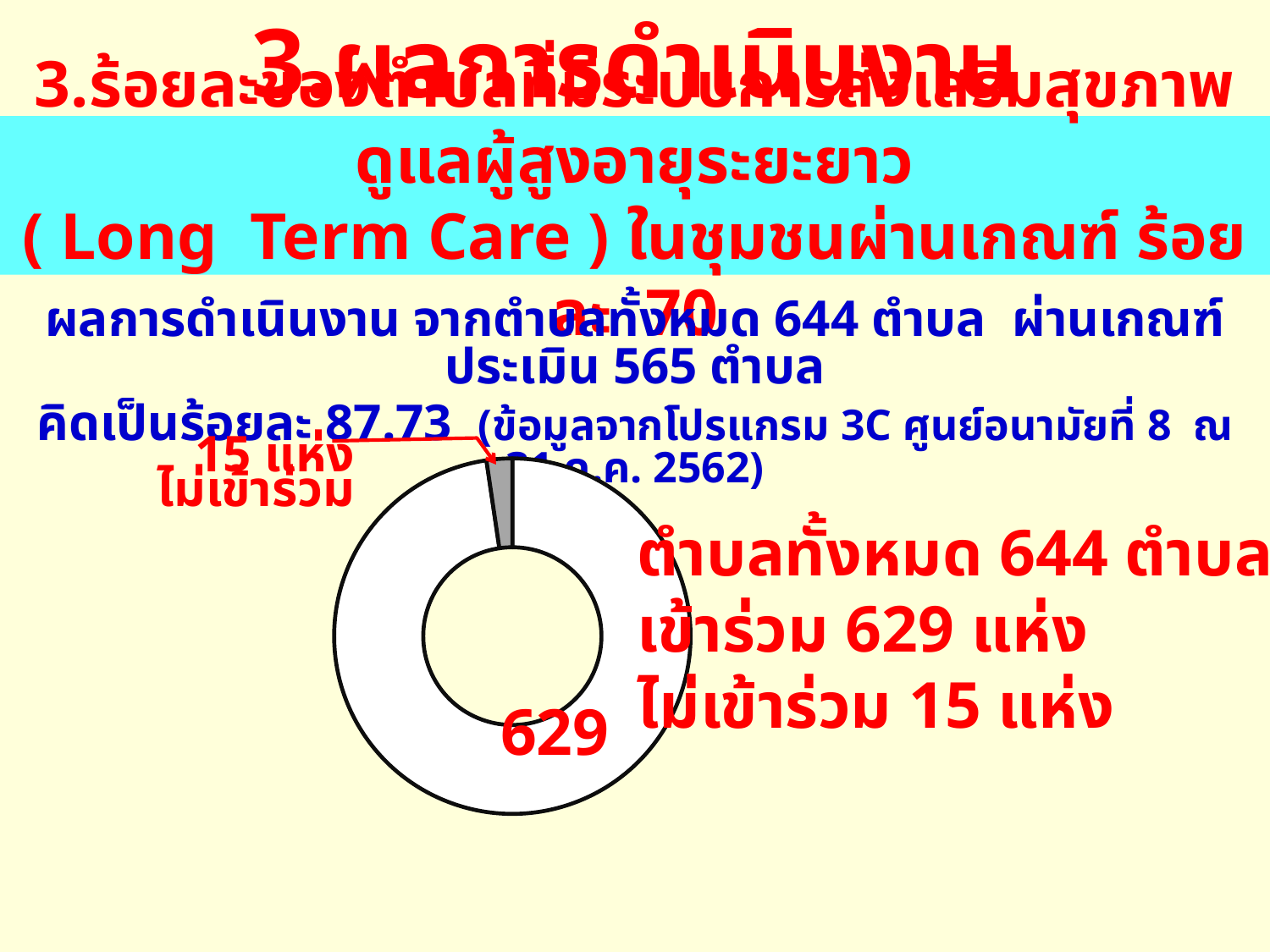
How many slices does the doughnut chart have? 2 What share of the total 644 sub-districts does the 15 ไม่เข้าร่วม slice represent, to one decimal place? 2.3% What is the difference between the number of participating (629) and non-participating (15) sub-districts? 614 What colour is the slice representing the 15 non-participating sub-districts? Grey Which slice of the doughnut chart is the largest? 629 (เข้าร่วม) What is the total of the two slices in the doughnut chart? 644 What value is given for the small grey slice labelled ไม่เข้าร่วม? 15 แห่ง What kind of chart is shown on the slide? Doughnut (pie) chart Which is larger: the slice for เข้าร่วม or the slice for ไม่เข้าร่วม? เข้าร่วม What value is printed on the large white slice of the doughnut chart? 629 According to the text beside the chart, how many sub-districts are there in total (ตำบลทั้งหมด)? 644 ตำบล Which slice of the doughnut chart is the smallest? 15 แห่ง ไม่เข้าร่วม